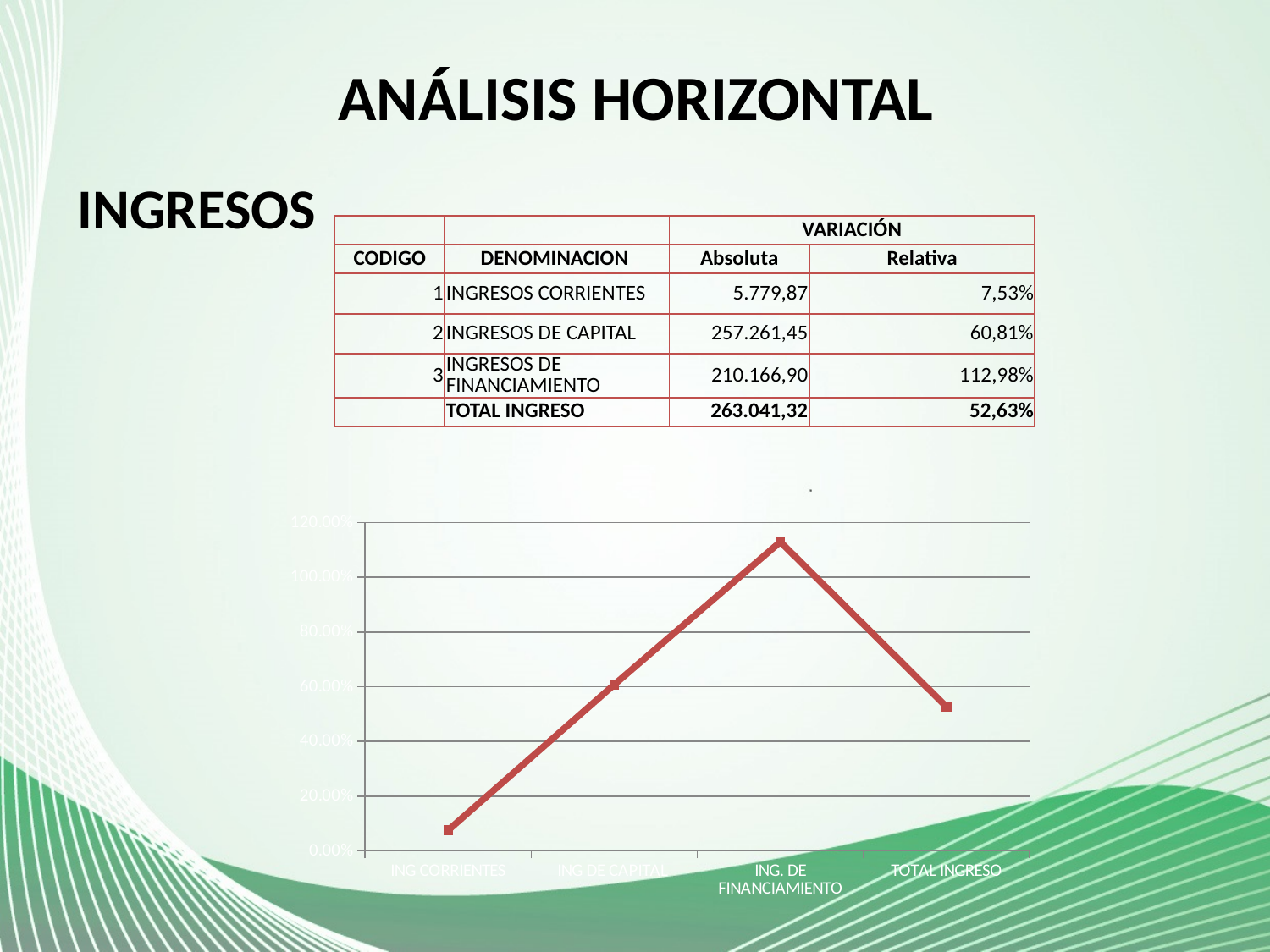
What is the highest tick value shown on the chart's vertical axis? 120.00% What kind of chart is shown on the slide? line chart Is the value for TOTAL INGRESO greater or less than 40.00%? greater Does the line rise or fall between ING CORRIENTES and ING. DE FINANCIAMIENTO? rises Is the value for ING DE CAPITAL greater or less than 80.00%? less How many categories are plotted along the x axis of the chart? 4 Which category has the highest value in the chart? ING. DE FINANCIAMIENTO Is the value for ING. DE FINANCIAMIENTO greater or less than 100.00%? greater Which is larger in the chart, the value for ING DE CAPITAL or the value for TOTAL INGRESO? ING DE CAPITAL Which category has the lowest value in the chart? ING CORRIENTES What colour is the line plotted in the chart? red